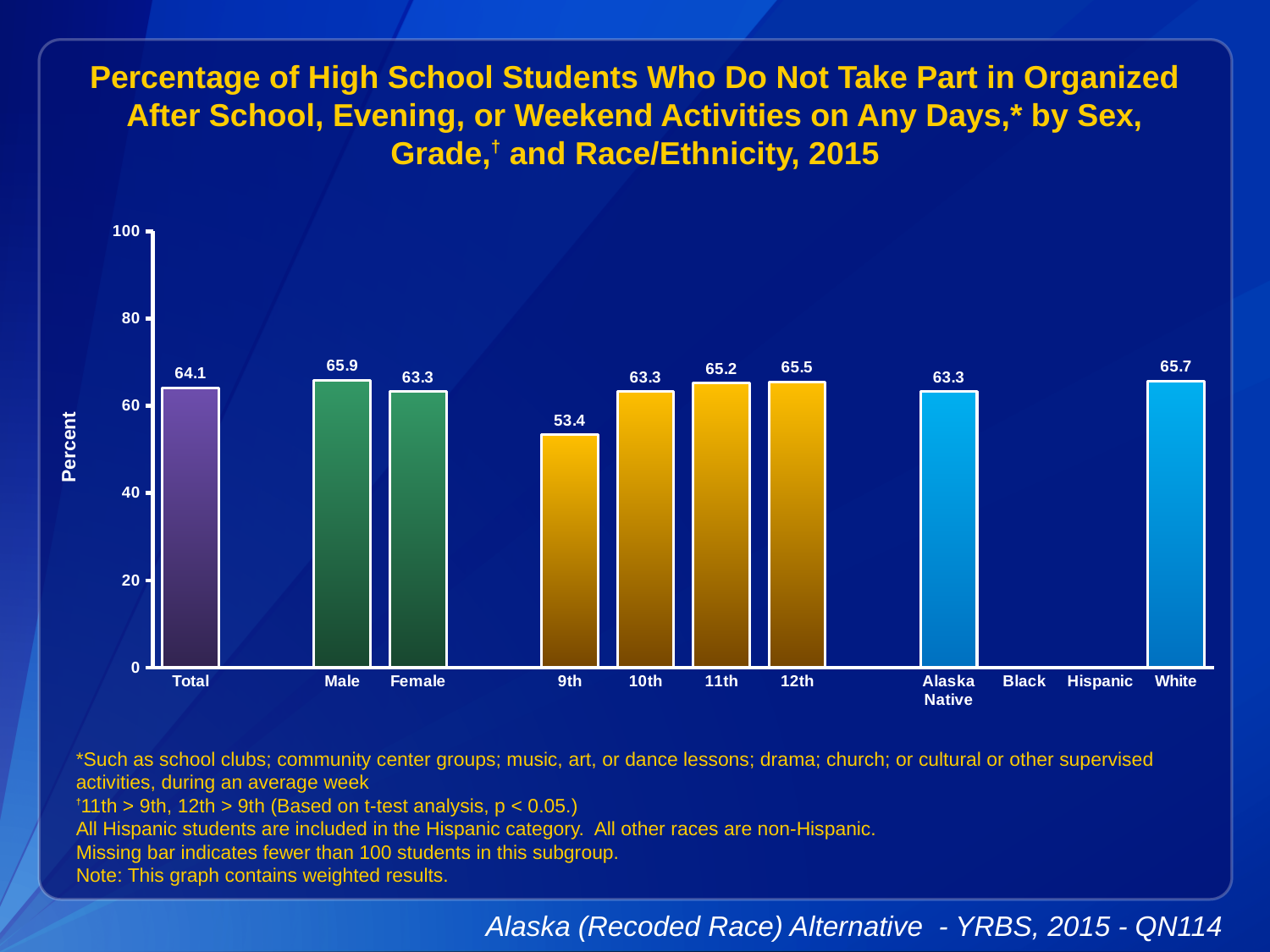
What is the value for Total? 64.1 Which category has the lowest value? 9th Is the value for 9th grade greater or less than 60? less What kind of chart is shown on the slide? bar chart What is the value for White? 65.7 What is the difference between the values for 12th grade and 9th grade? 12.1 What is the value for 9th grade? 53.4 What is the value for Male? 65.9 Which is larger, the value for 11th grade or the value for 10th grade? 11th What is the difference between the values for Male and Female? 2.6 How many bars are plotted on the chart? 9 Which category has the highest value? Male